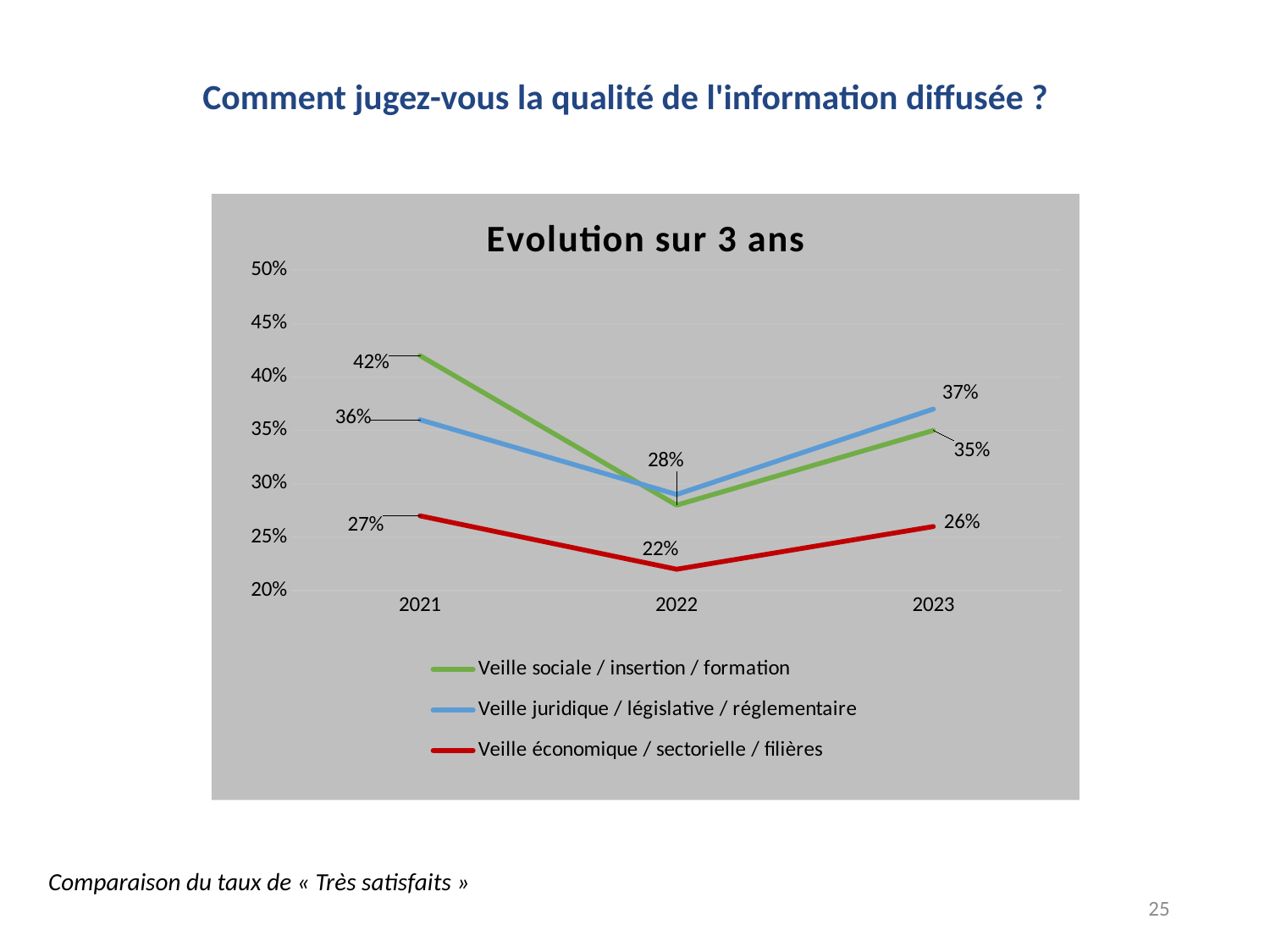
What is the value for Veille sociale / insertion / formation in 2021? 42% What is the value for Veille économique / sectorielle / filières in 2023? 26% How many years are plotted along the x axis of the chart? 3 How many series does the legend of the chart list? 3 Which series has the highest value in 2021? Veille sociale / insertion / formation By how many percentage points did Veille sociale / insertion / formation change from 2021 (42%) to 2023 (35%)? 7 percentage points lower What is the title of the chart? Evolution sur 3 ans What is the value for Veille juridique / législative / réglementaire in 2023? 37% Which series has the lowest value in 2023? Veille économique / sectorielle / filières What is the value for Veille juridique / législative / réglementaire in 2021? 36% What is the value for Veille économique / sectorielle / filières in 2022? 22% What type of chart is shown on the slide? Line chart